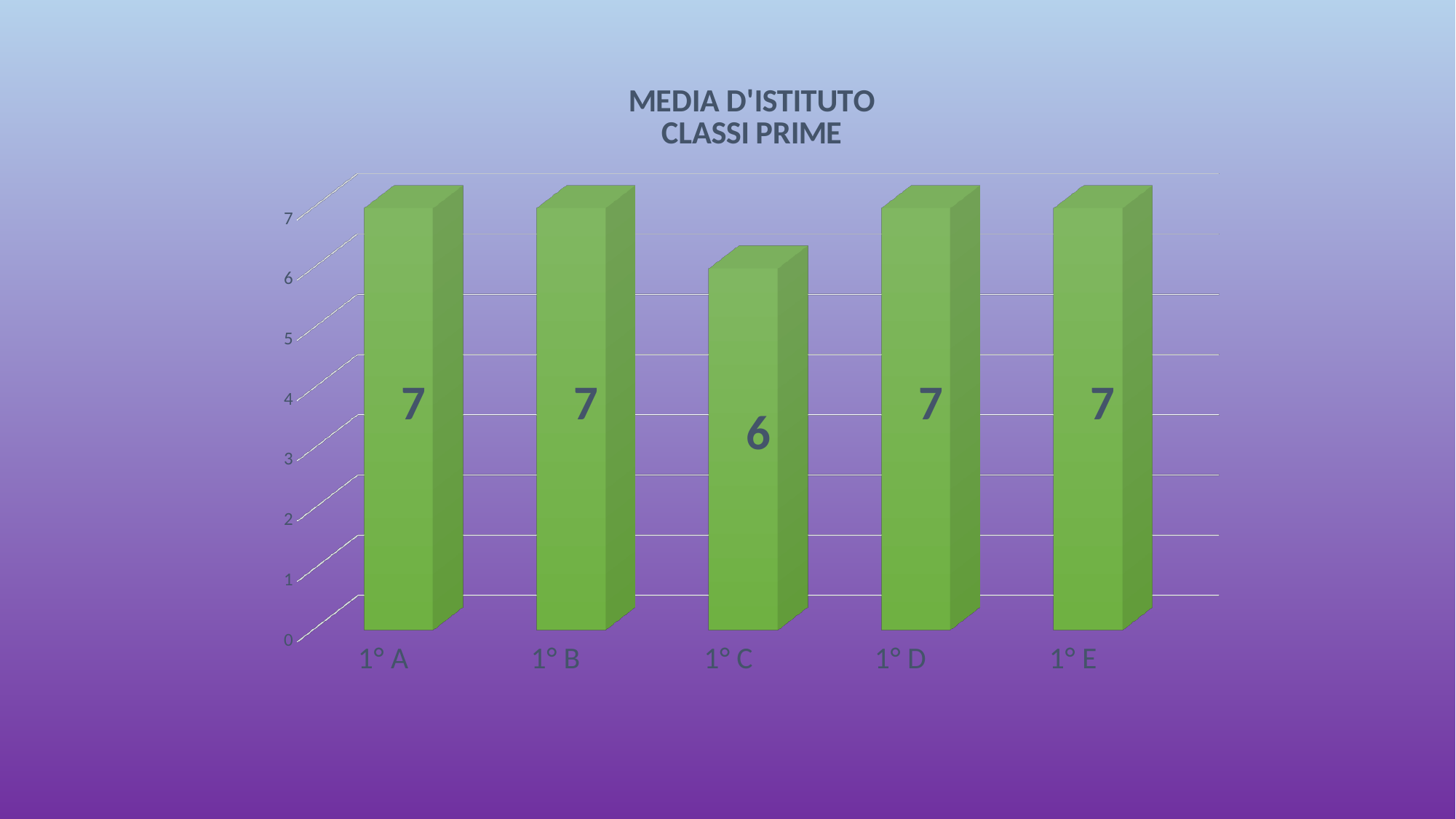
What is the title of the chart? MEDIA D'ISTITUTO CLASSI PRIME Which class has the lowest value? 1° C What is the value for 1° A? 7 Is the value for 1° D greater or less than 4? greater What colour are the bars in the chart? green Which is larger, the value for 1° B or the value for 1° C? 1° B Is the value for 1° C greater or less than 5? greater How many classes are shown on the x axis? 5 What kind of chart is shown on the slide? bar chart What is the difference between the values for 1° A and 1° C? 1 What is the value for 1° C? 6 What is the value for 1° E? 7